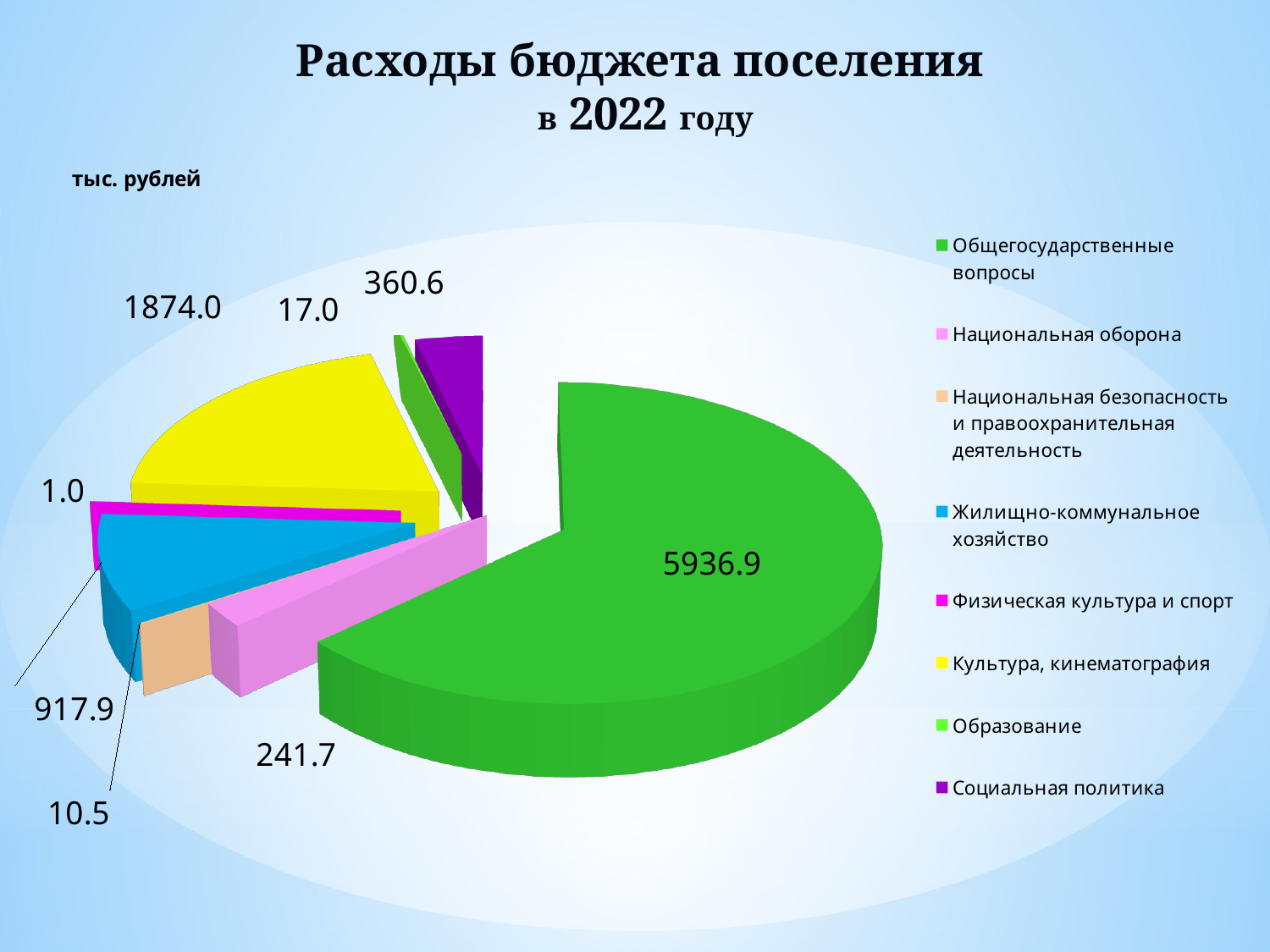
What is the value for Социальная политика? 360.6 What is the value for Культура, кинематография? 1874.0 What is the value for Жилищно-коммунальное хозяйство? 917.9 What is the value for Общегосударственные вопросы? 5936.9 How many categories does the legend list? 8 Which category has the largest slice of the pie? Общегосударственные вопросы Which category has the smallest value? Физическая культура и спорт Which is larger, the value for Социальная политика or the value for Национальная оборона? Социальная политика What kind of chart is shown on the slide? Pie chart What unit is stated for the values on the chart? тыс. рублей What is the value for Национальная оборона? 241.7 What is the difference between the values for Культура, кинематография and Жилищно-коммунальное хозяйство? 956.1